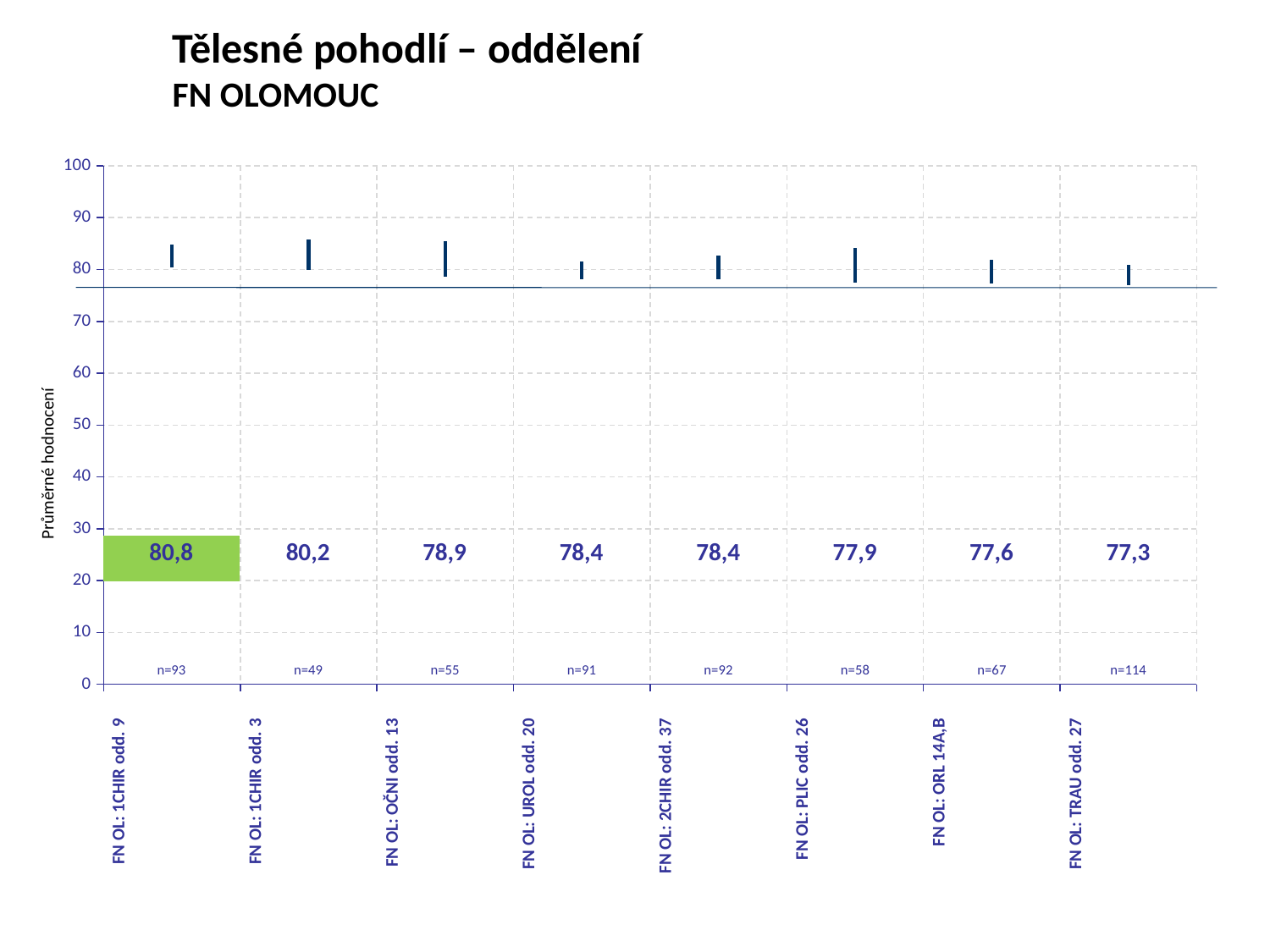
Which has a higher average rating, FN OL: OČNI odd. 13 or FN OL: ORL 14A,B? FN OL: OČNI odd. 13 What is the number of respondents (n) for FN OL: TRAU odd. 27? n=114 How many departments are shown on the chart? 8 Which department has the highest average rating? FN OL: 1CHIR odd. 9 Do the average ratings rise or fall from left to right across the departments? fall What is the number of respondents (n) for FN OL: 1CHIR odd. 3? n=49 What is the average rating (průměrné hodnocení) for FN OL: 1CHIR odd. 9? 80,8 What is the label of the vertical axis? Průměrné hodnocení What is the average rating for FN OL: TRAU odd. 27? 77,3 Which department has the lowest average rating? FN OL: TRAU odd. 27 What is the average rating for FN OL: PLIC odd. 26? 77,9 What is the difference between the average ratings of FN OL: 1CHIR odd. 9 and FN OL: TRAU odd. 27? 3,5